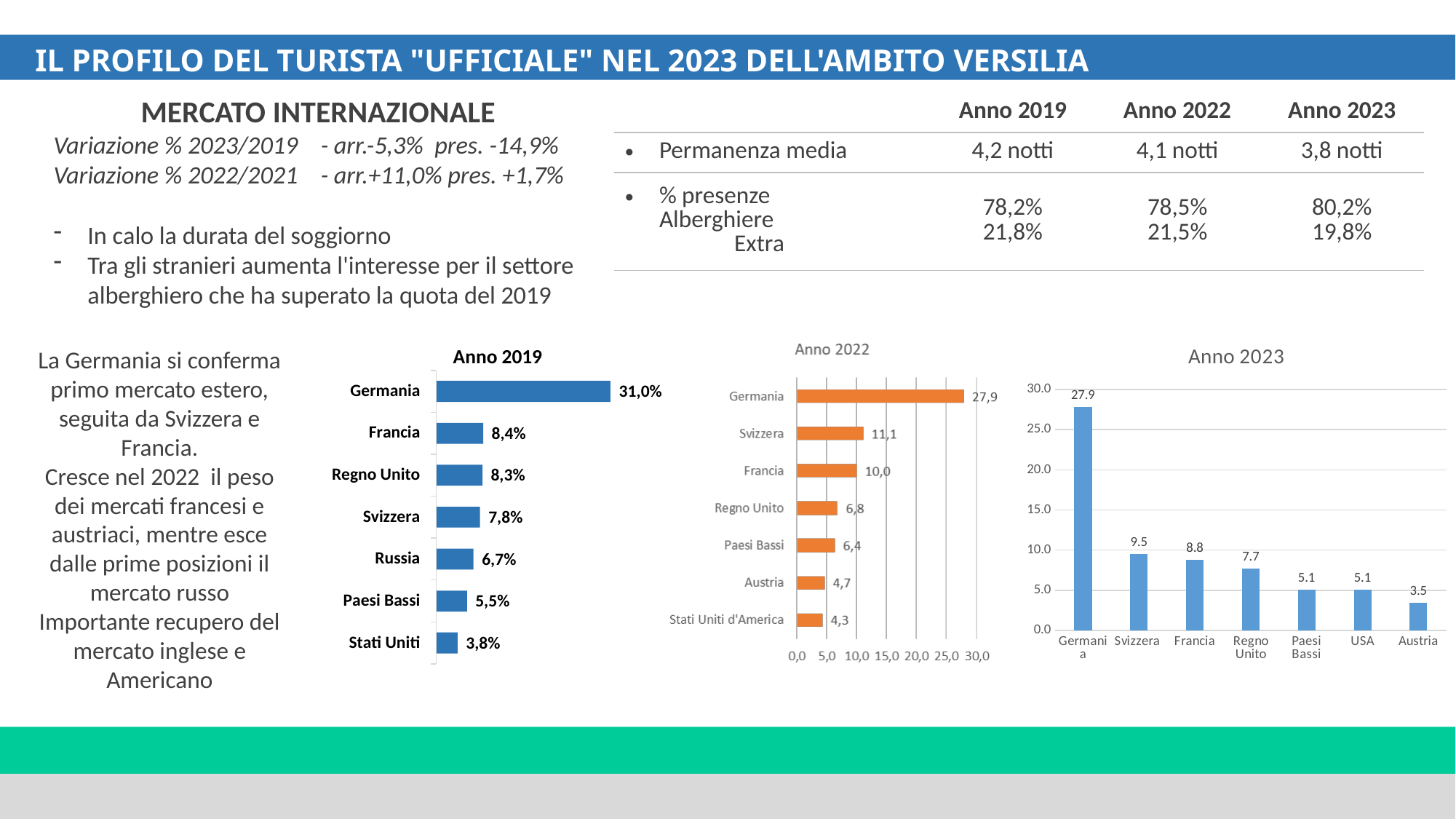
In the 'Anno 2019' chart, what is the difference between Francia and Svizzera? 0,6% In the 'Anno 2023' chart, how many categories are shown? 7 In the 'Anno 2019' chart, what is the value for Germania? 31,0% In the 'Anno 2022' chart, what is the difference between Germania and Francia? 17,9 In the 'Anno 2023' chart, what kind of chart is shown? Bar chart In the 'Anno 2023' chart, what is the value for Austria? 3.5 In the 'Anno 2019' chart, how many categories are shown? 7 In the 'Anno 2022' chart, which is larger: Regno Unito or Paesi Bassi? Regno Unito In the 'Anno 2022' chart, which category has the highest value? Germania In the 'Anno 2019' chart, which category has the lowest value? Stati Uniti In the 'Anno 2023' chart, what is the difference between Svizzera and Francia? 0.7 In the 'Anno 2022' chart, what is the value for Svizzera? 11,1